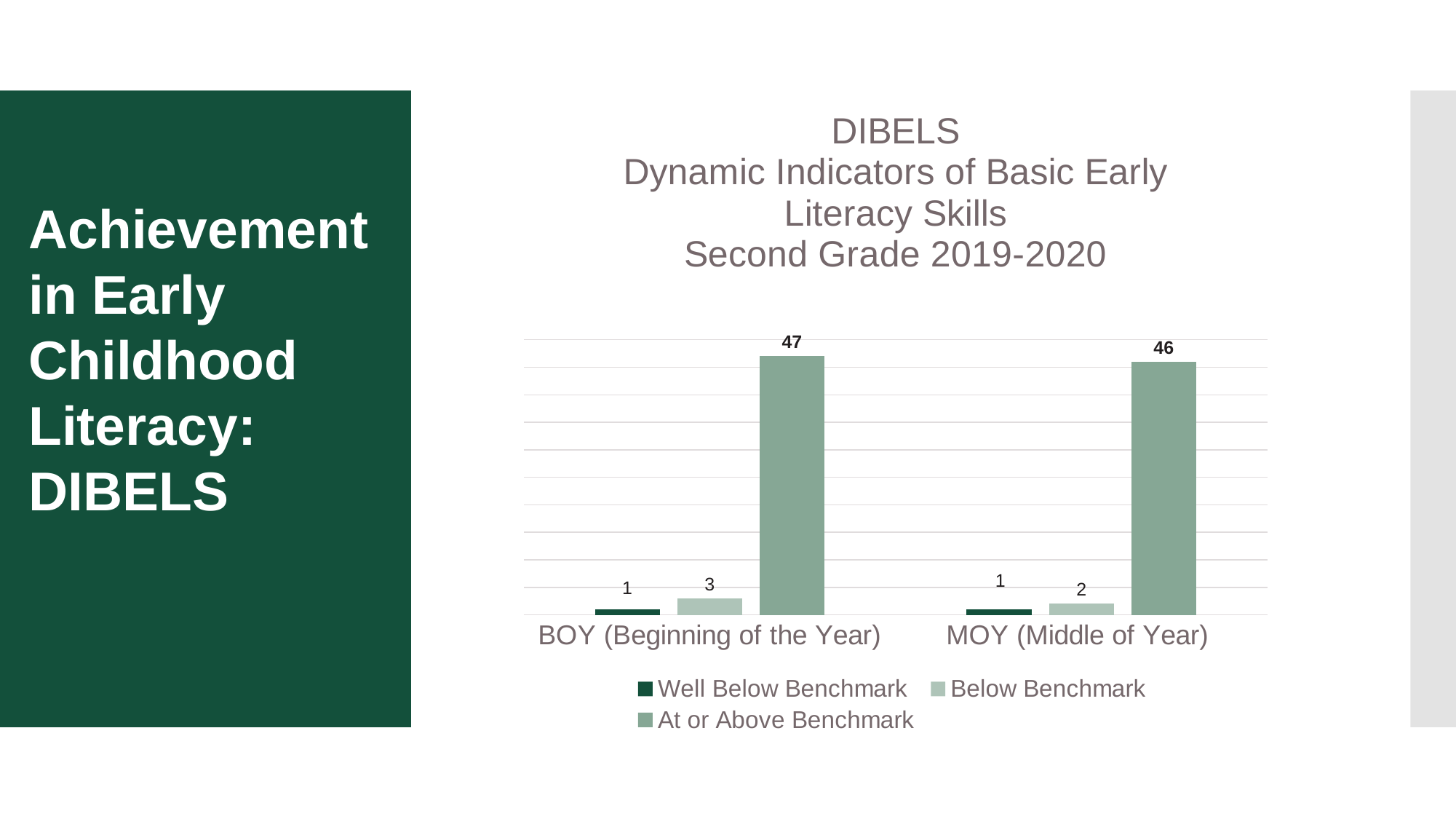
What is the difference between the At or Above Benchmark values at BOY and MOY? 1 What is the value for At or Above Benchmark at BOY (Beginning of the Year)? 47 Is the Below Benchmark value larger at BOY (Beginning of the Year) or at MOY (Middle of Year)? BOY (Beginning of the Year) How many series does the legend list? 3 What is the value for Well Below Benchmark at BOY (Beginning of the Year)? 1 Which series has the lowest value at BOY (Beginning of the Year)? Well Below Benchmark What is the difference between Below Benchmark and Well Below Benchmark at BOY (Beginning of the Year)? 2 How many categories are shown on the x axis? 2 Which series has the highest value at MOY (Middle of Year)? At or Above Benchmark What kind of chart is shown on the slide? Bar chart What is the value for Below Benchmark at MOY (Middle of Year)? 2 What is the value for At or Above Benchmark at MOY (Middle of Year)? 46